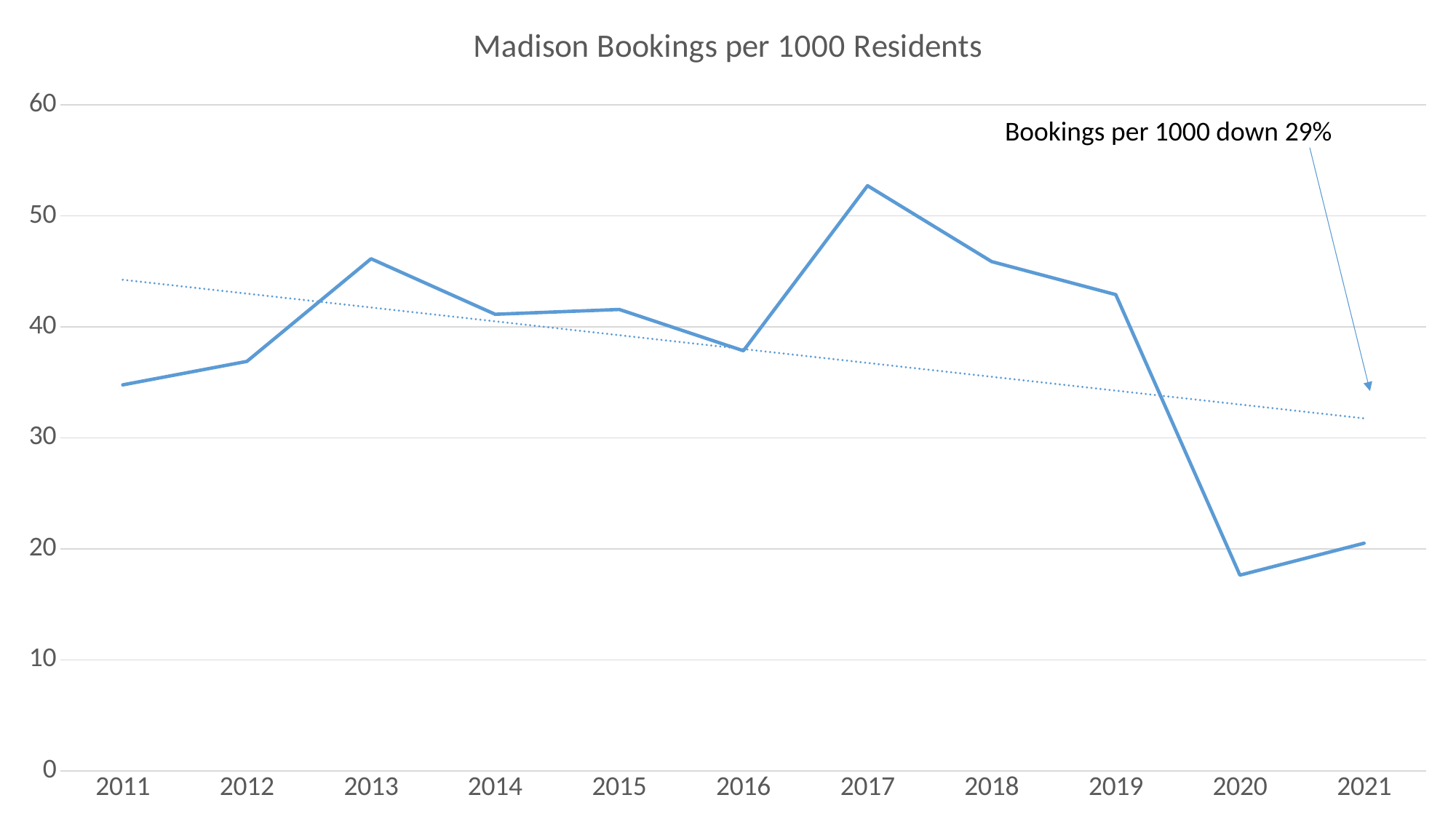
Is the value for 2017 greater or less than 50? greater Which year has the larger value, 2019 or 2021? 2019 Which year has the highest bookings per 1000 residents? 2017 Is the value for 2020 greater or less than 20? less What does the text annotation on the chart say? Bookings per 1000 down 29% Is the value for 2013 greater or less than 40? greater Does the dotted trend line rise or fall from 2011 to 2021? fall How many years are plotted along the x axis? 11 What is the title of the chart? Madison Bookings per 1000 Residents Which year has the lowest bookings per 1000 residents? 2020 What kind of chart is shown on the slide? line chart